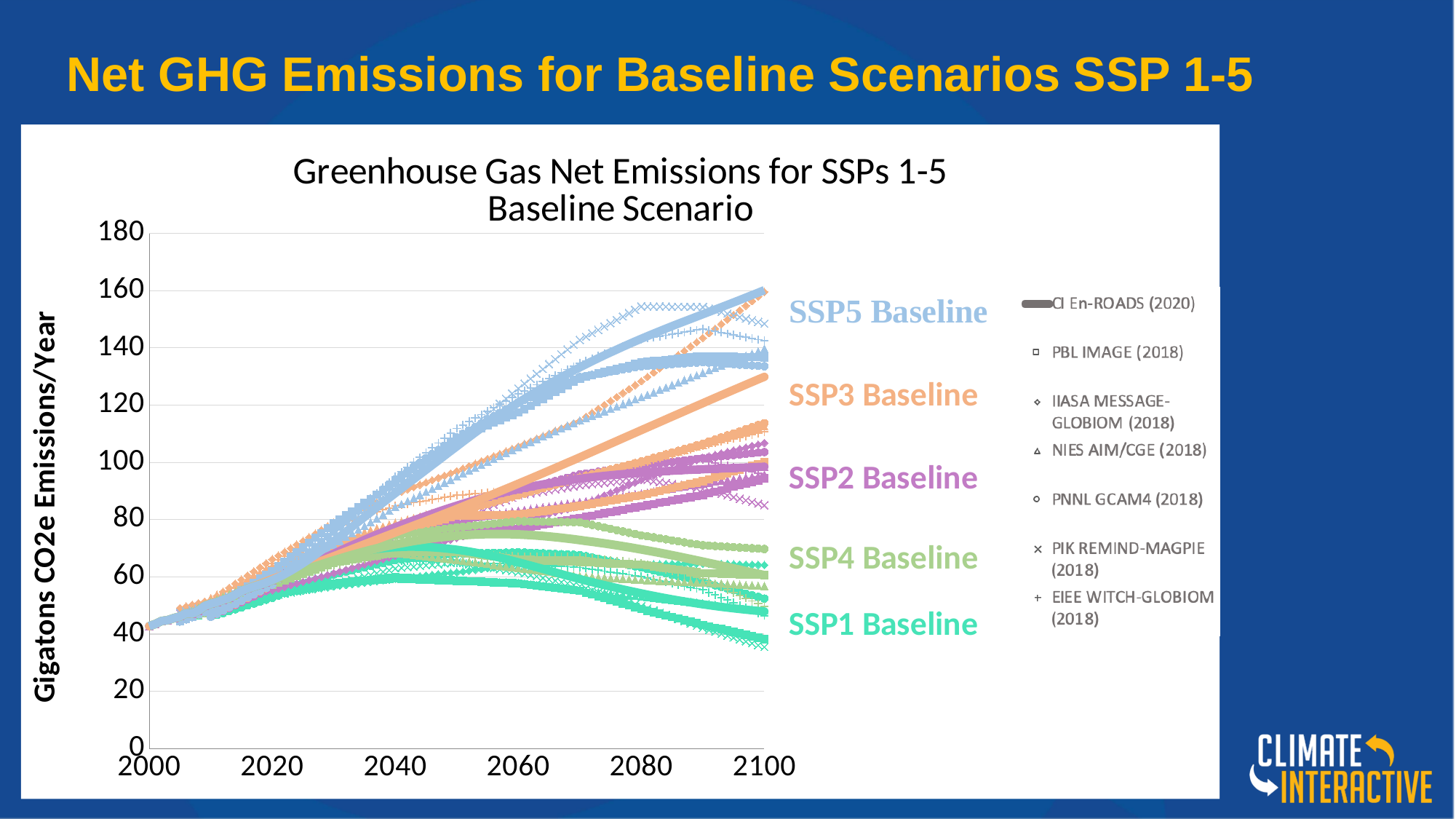
Which SSP baseline scenario has the lowest emissions in 2100? SSP1 Baseline Do the SSP5 Baseline emissions rise or fall between 2000 and 2100? rise Which SSP baseline scenario has the highest emissions in 2100? SSP5 Baseline Is the SSP1 Baseline value in 2100 greater or less than 60 gigatons CO2e per year? less How many model sources are listed in the chart's legend? 7 Is the SSP3 Baseline CI En-ROADS value in 2100 greater or less than 100 gigatons CO2e per year? greater How many SSP baseline scenarios are labelled on the chart? 5 In 2100, which scenario has higher emissions, SSP3 Baseline or SSP4 Baseline? SSP3 Baseline What is the label on the vertical axis of the chart? Gigatons CO2e Emissions/Year Do the SSP1 Baseline emissions rise or fall between 2060 and 2100? fall What is the title of the chart? Greenhouse Gas Net Emissions for SSPs 1-5 Baseline Scenario What kind of chart is shown on the slide? line chart